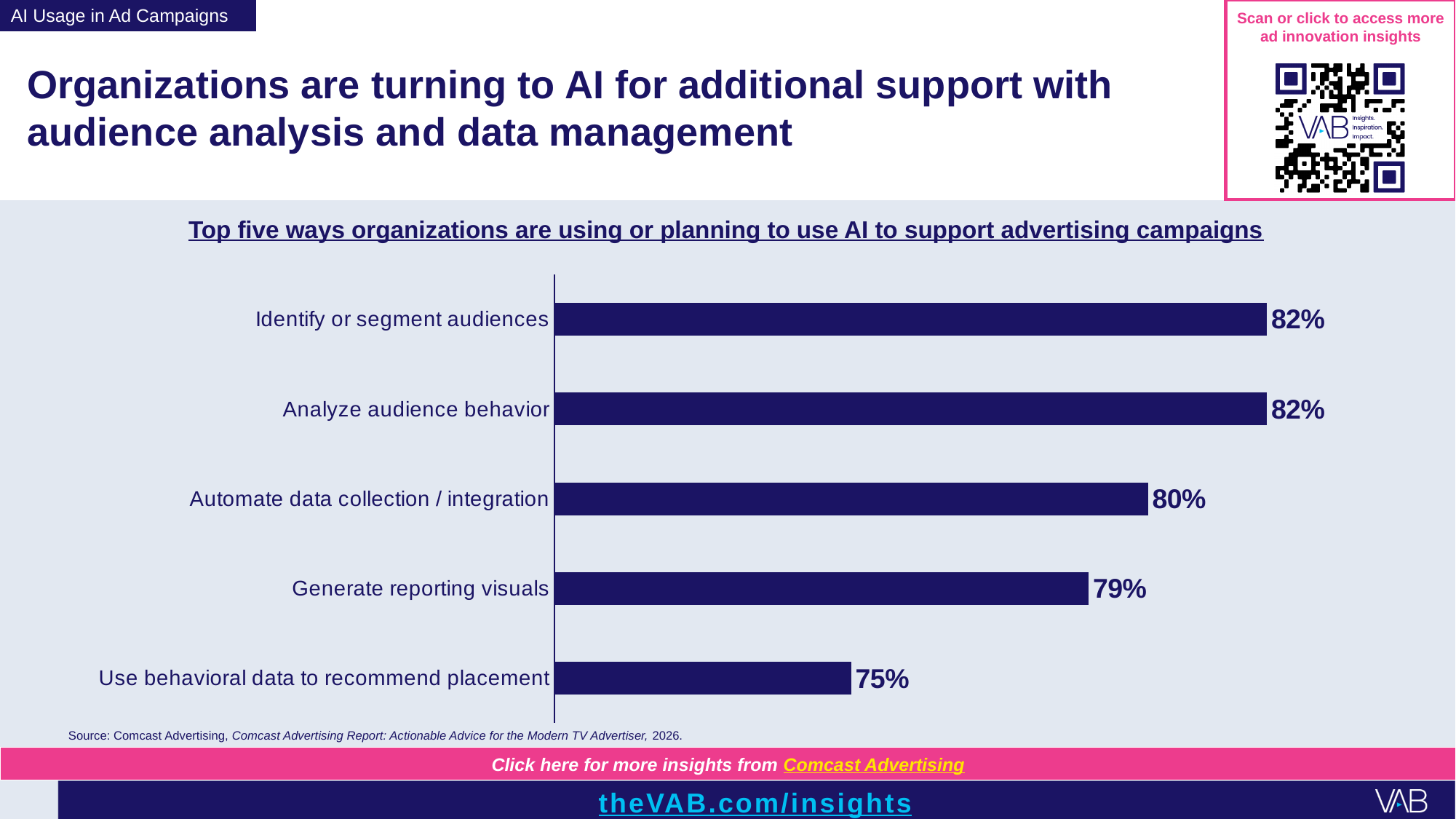
Which category has the lowest value on the chart? Use behavioral data to recommend placement Do the values rise or fall going from the top bar to the bottom bar? Fall What is the value shown for 'Generate reporting visuals'? 79% How many categories are shown on the chart? 5 What kind of chart is shown on the slide? Bar chart What is the value shown for 'Automate data collection / integration'? 80% What is the difference between the values for 'Analyze audience behavior' and 'Use behavioral data to recommend placement'? 7% What is the difference between the values for 'Automate data collection / integration' and 'Generate reporting visuals'? 1% What is the value shown for 'Use behavioral data to recommend placement'? 75% What is the title of the chart? Top five ways organizations are using or planning to use AI to support advertising campaigns What percentage of organizations are using or planning to use AI to identify or segment audiences? 82% Which is larger: the value for 'Automate data collection / integration' or the value for 'Use behavioral data to recommend placement'? Automate data collection / integration